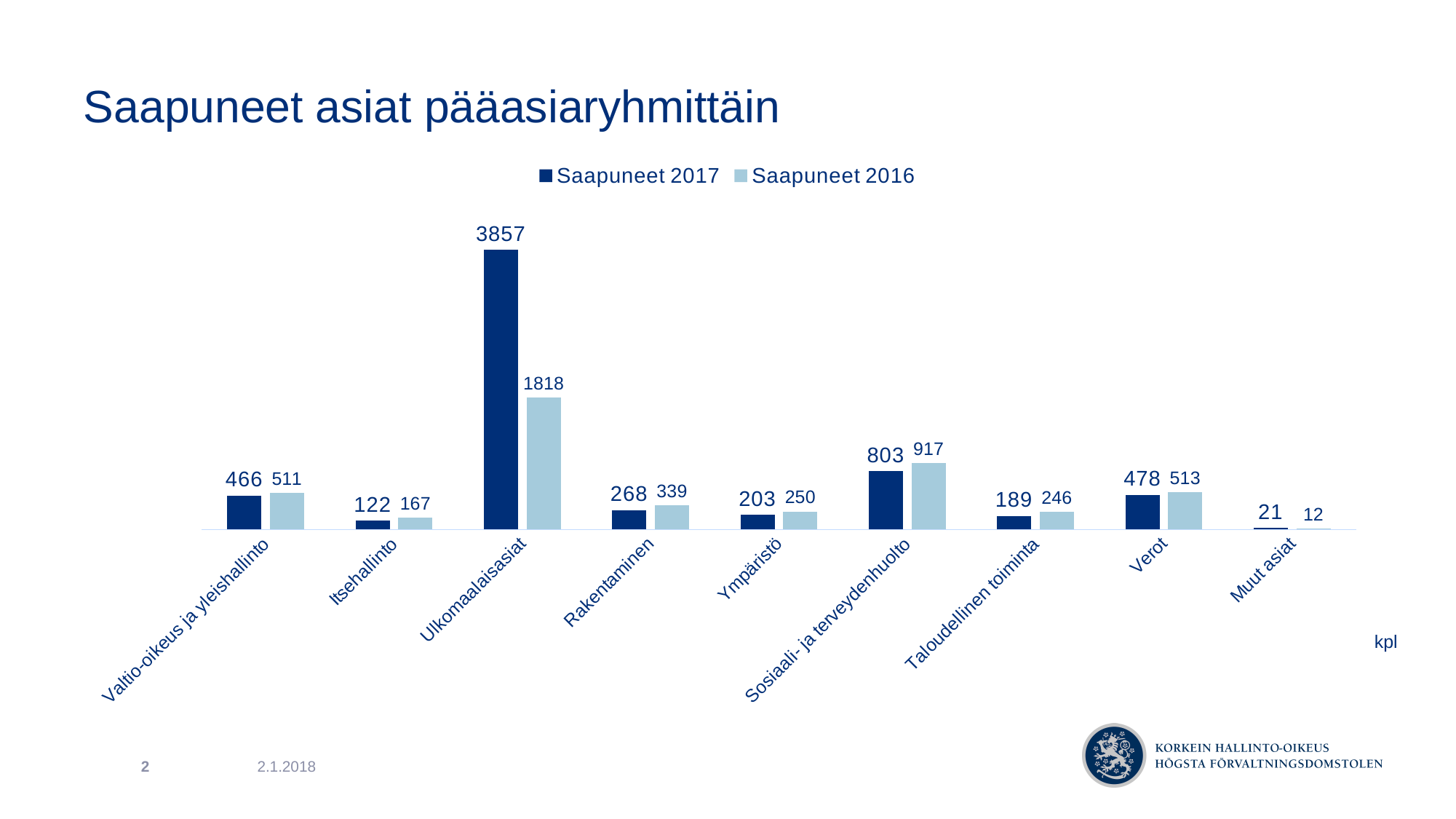
Which category has the highest Saapuneet 2017 value? Ulkomaalaisasiat What is the difference between the Saapuneet 2016 and Saapuneet 2017 values for Rakentaminen? 71 For Itsehallinto, which is larger: Saapuneet 2017 or Saapuneet 2016? Saapuneet 2016 Which category has the lowest Saapuneet 2016 value? Muut asiat What is the difference between the Saapuneet 2017 and Saapuneet 2016 values for Ulkomaalaisasiat? 2039 How many series does the legend list? 2 What is the Saapuneet 2017 value for Verot? 478 How many categories are shown on the x axis? 9 What is the Saapuneet 2016 value for Sosiaali- ja terveydenhuolto? 917 What is the Saapuneet 2017 value for Ulkomaalaisasiat? 3857 What kind of chart is shown on the slide? Bar chart For Muut asiat, which is larger: Saapuneet 2017 or Saapuneet 2016? Saapuneet 2017